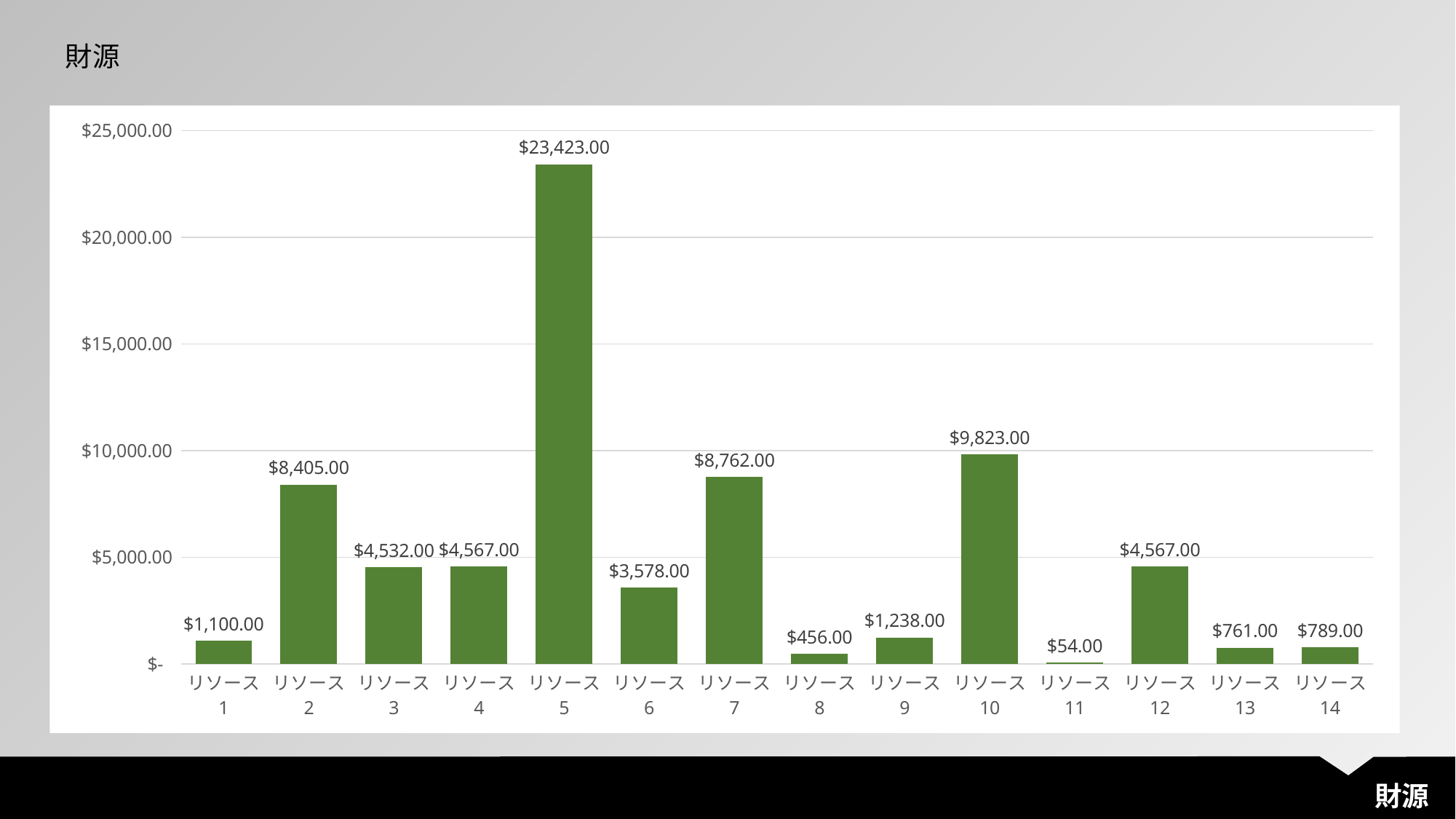
Which is larger, the value for リソース 2 or the value for リソース 7? リソース 7 What is the value for リソース 5? $23,423.00 How many categories are shown on the x axis? 14 Is the value for リソース 5 greater or less than $20,000.00? greater What is the difference between the values for リソース 10 and リソース 7? $1,061.00 Which category has the highest value? リソース 5 What is the value for リソース 10? $9,823.00 What is the title of the slide? 財源 What kind of chart is shown on the slide? bar chart What is the value for リソース 11? $54.00 What is the difference between the values for リソース 14 and リソース 13? $28.00 Which category has the lowest value? リソース 11